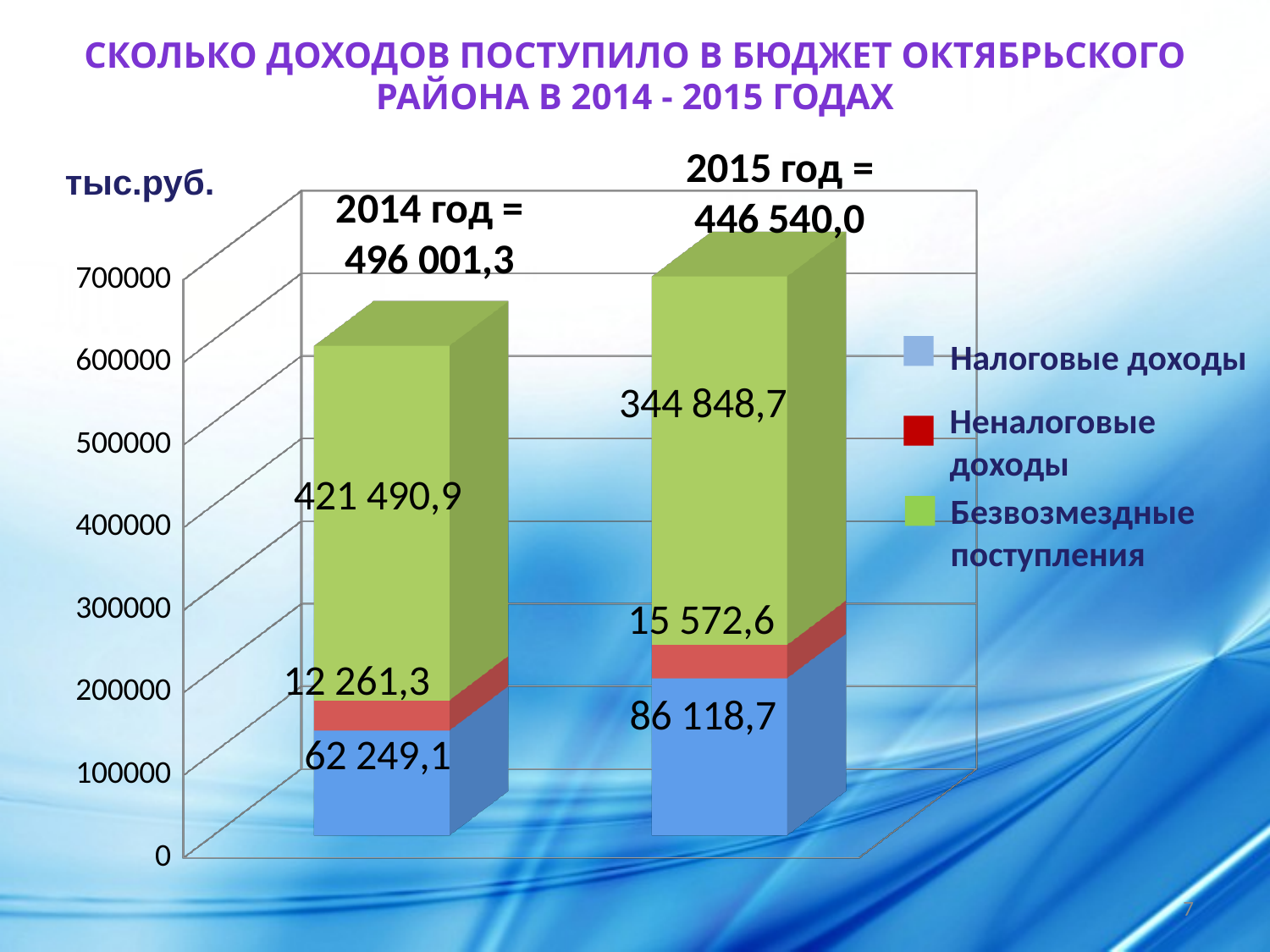
How many years (bars) are shown in the chart? 2 What is the total of the stacked bar for 2015? 446 540,0 What is the value of Налоговые доходы for 2014? 62 249,1 Which year has the larger value for Безвозмездные поступления, 2014 or 2015? 2014 What is the total of the stacked bar for 2014? 496 001,3 What is the value of Безвозмездные поступления for 2015? 344 848,7 What unit of measurement is indicated for the chart values? тыс.руб. How many series does the legend list? 3 What type of chart is shown on the slide? Stacked bar chart What is the difference between Налоговые доходы in 2015 and in 2014? 23 869,6 Which series is the largest component of the 2015 bar? Безвозмездные поступления What is the value of Неналоговые доходы for 2015? 15 572,6